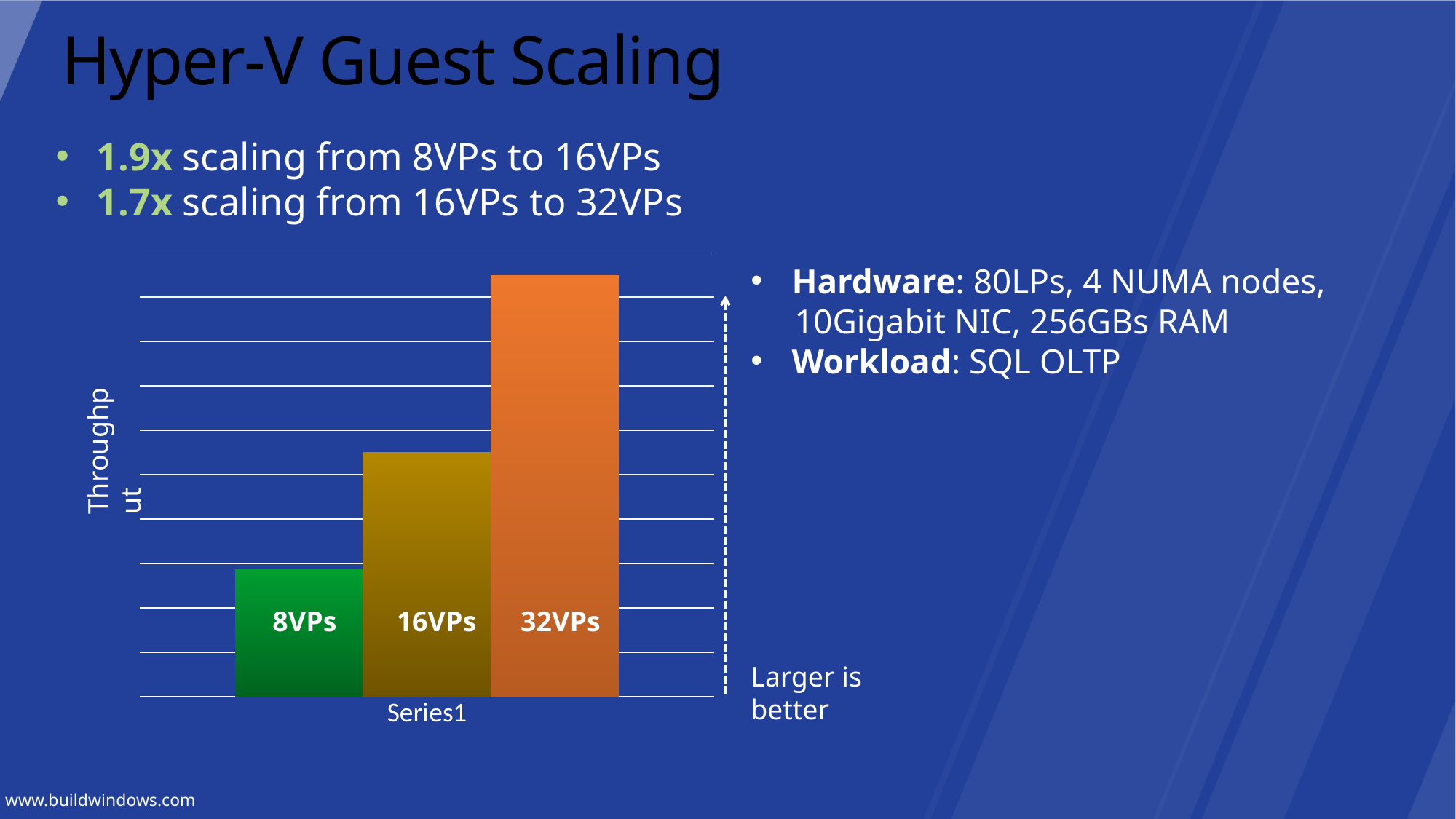
What kind of chart is shown on the slide? bar chart Which bar has the highest throughput? 32VPs What is the label on the vertical axis of the chart? Throughput How many bars are plotted in the chart? 3 Which bar has the lowest throughput? 8VPs Which has higher throughput, 8VPs or 16VPs? 16VPs What colour is the 8VPs bar? green Do the bars rise or fall from left to right across the chart? rise Which has higher throughput, 16VPs or 32VPs? 32VPs